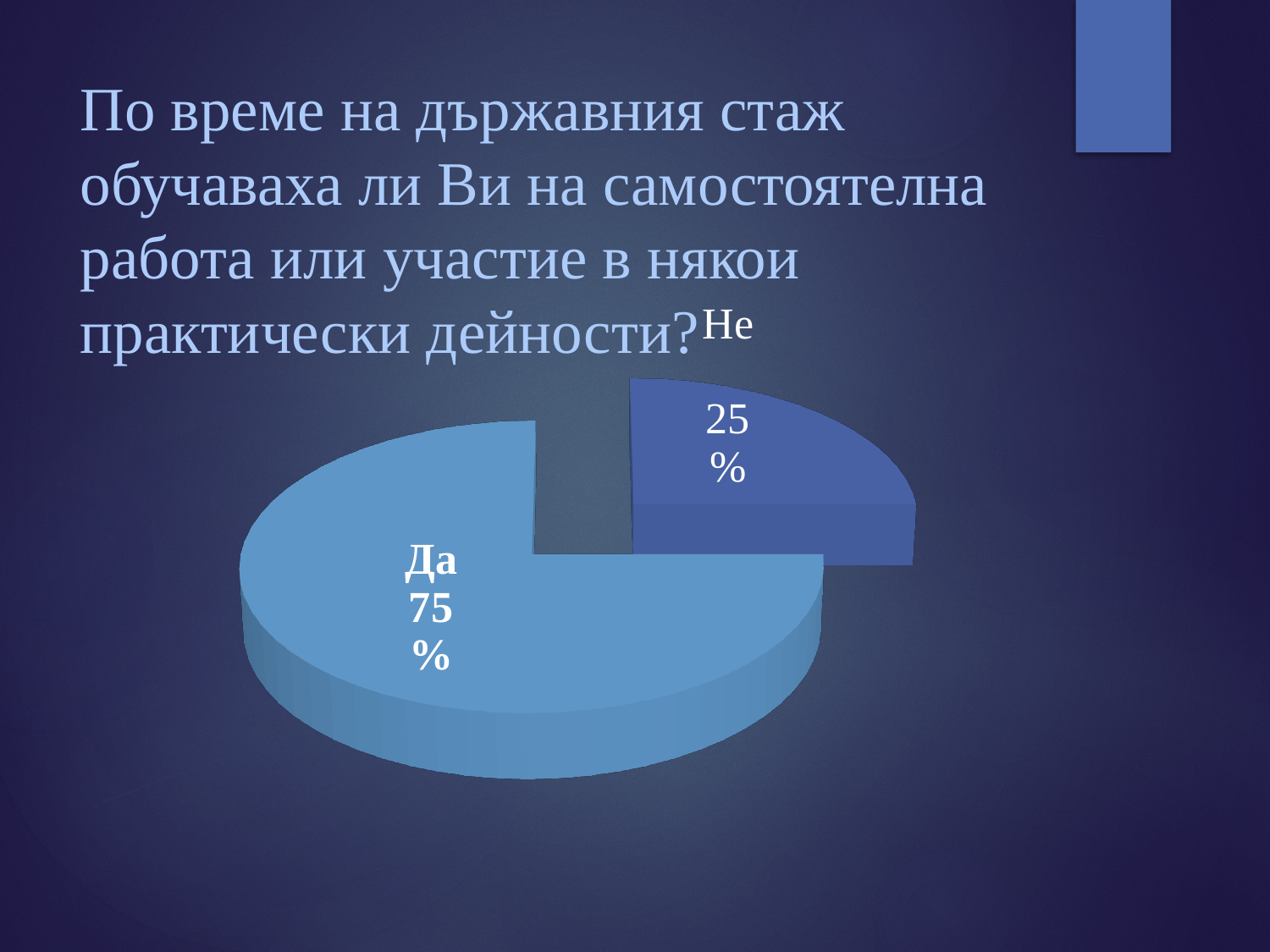
Which slice is larger, "Да" or "Не"? Да Is the share for "Да" greater or less than 50%? greater What kind of chart is shown on the slide? pie chart How many slices does the pie chart have? 2 Which slice is pulled out (exploded) from the pie? Не What percentage of the pie is labelled "Да"? 75% Which slice of the pie is the largest? Да Which slice is shown in the darker blue colour? Не What is the difference in percentage points between the "Да" and "Не" slices? 50 Which slice of the pie is the smallest? Не What share of the pie does the "Не" slice represent? 25% What percentage of the pie is labelled "Не"? 25%